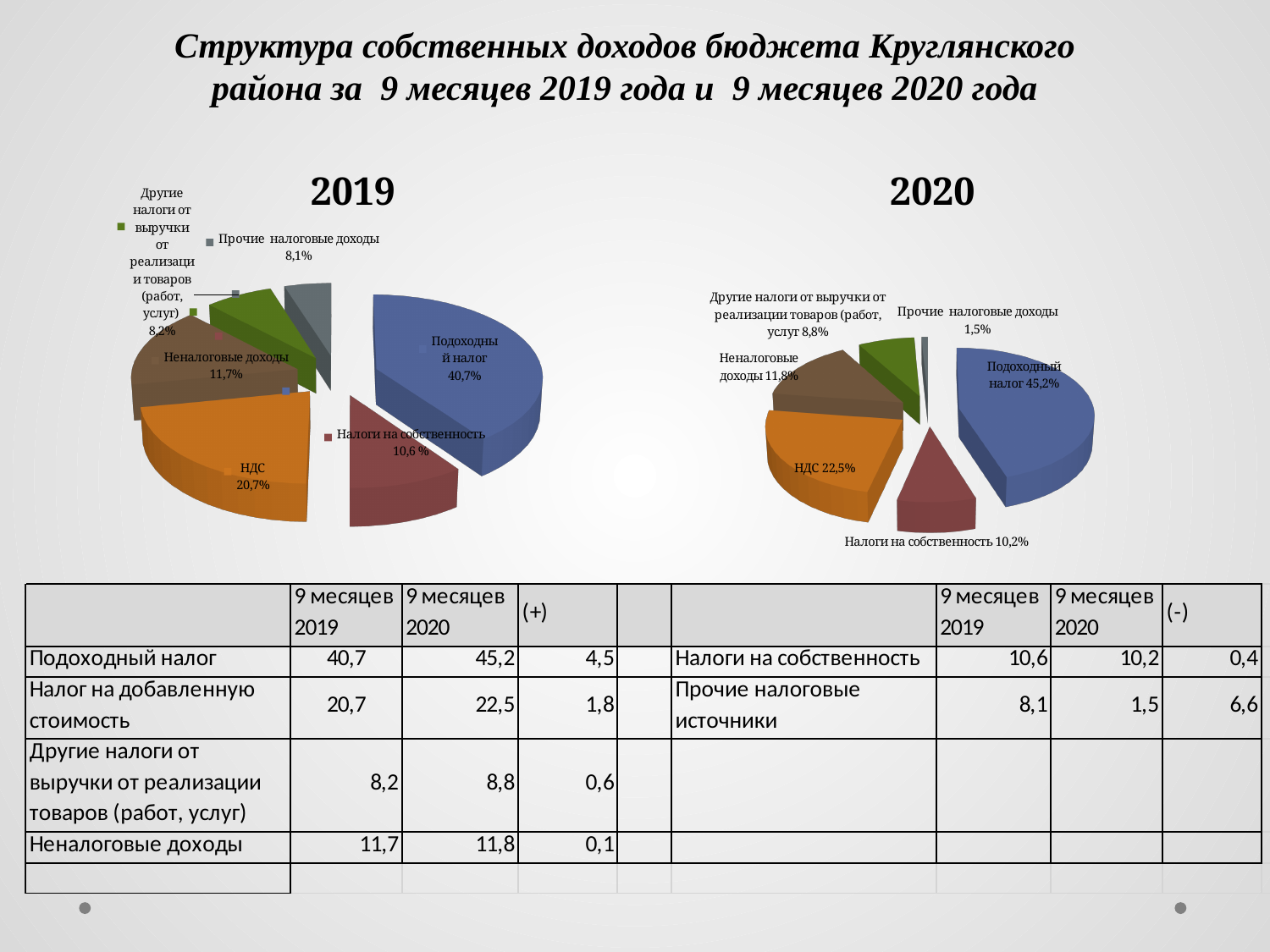
In the 2019 pie chart, which category has the smallest share? Прочие налоговые доходы In the 2019 pie chart, which category has the largest share? Подоходный налог In the 2019 pie chart, what share does Неналоговые доходы have? 11,7% How many slices does the 2020 pie chart have? 6 What type of chart is used for the 2019 data? Pie chart In the 2020 pie chart, what share does НДС have? 22,5% In the 2020 pie chart, what share does Прочие налоговые доходы have? 1,5% In the 2020 pie chart, which is larger: Неналоговые доходы or Налоги на собственность? Неналоговые доходы In the 2020 pie chart, which category has the smallest share? Прочие налоговые доходы In the 2019 pie chart, what share does Подоходный налог have? 40,7% What is the difference between the share of Подоходный налог in the 2020 pie chart and in the 2019 pie chart? 4,5 What is the difference between the share of НДС in the 2020 pie chart and in the 2019 pie chart? 1,8